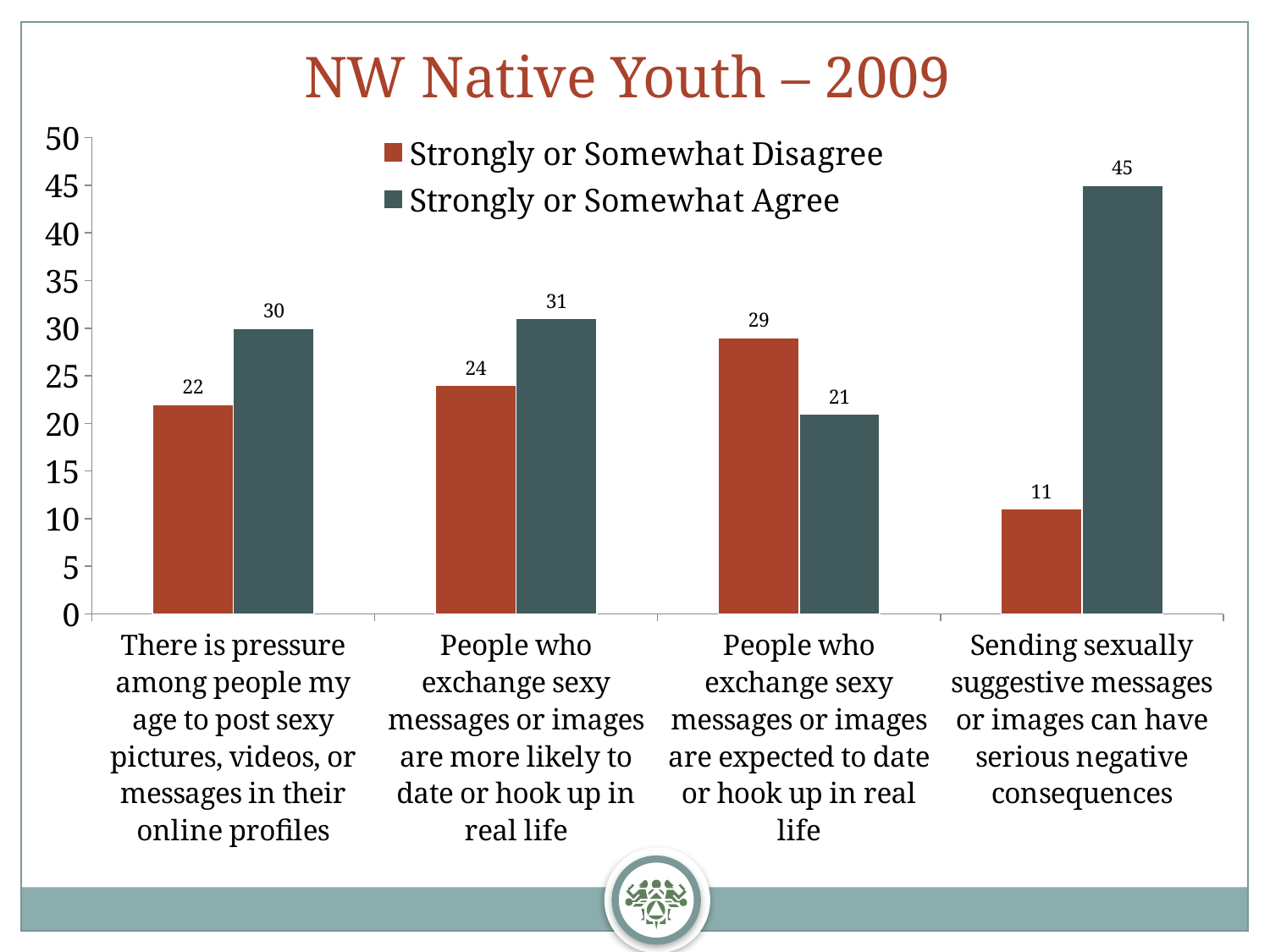
Which category has the highest 'Strongly or Somewhat Disagree' value? People who exchange sexy messages or images are expected to date or hook up in real life What is the 'Strongly or Somewhat Disagree' value for 'There is pressure among people my age to post sexy pictures, videos, or messages in their online profiles'? 22 How many series does the legend list? 2 For 'People who exchange sexy messages or images are more likely to date or hook up in real life', which is larger: the Agree value or the Disagree value? Strongly or Somewhat Agree What kind of chart is shown on the slide? Bar chart How many categories are shown on the x axis? 4 What is the title of the chart? NW Native Youth – 2009 Which category has the lowest 'Strongly or Somewhat Agree' value? People who exchange sexy messages or images are expected to date or hook up in real life Is the 'Strongly or Somewhat Disagree' value for 'Sending sexually suggestive messages or images can have serious negative consequences' greater or less than 15? less What is the 'Strongly or Somewhat Agree' value for 'People who exchange sexy messages or images are expected to date or hook up in real life'? 21 What is the difference between the 'Strongly or Somewhat Agree' and 'Strongly or Somewhat Disagree' values for 'Sending sexually suggestive messages or images can have serious negative consequences'? 34 What is the 'Strongly or Somewhat Agree' value for 'Sending sexually suggestive messages or images can have serious negative consequences'? 45